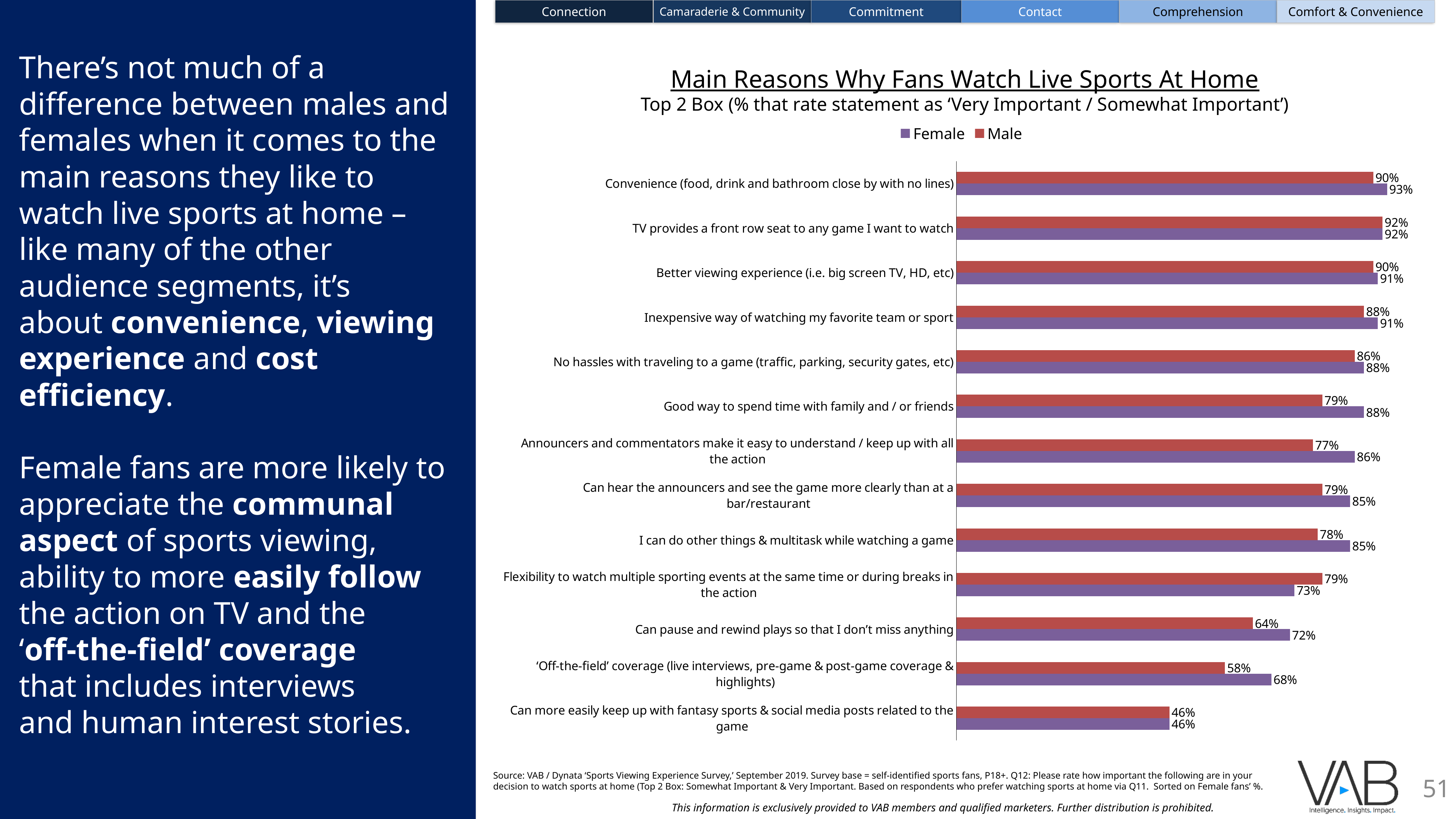
What is the difference between the Female and Male values for ''Off-the-field' coverage (live interviews, pre-game & post-game coverage & highlights)'? 10% What is the Male value for 'Can pause and rewind plays so that I don't miss anything'? 64% What is the difference between the Female and Male values for 'Good way to spend time with family and / or friends'? 9% What is the subtitle shown under the chart title? Top 2 Box (% that rate statement as 'Very Important / Somewhat Important') What kind of chart is shown on the slide? bar chart How many series does the legend list? 2 How many reasons (categories) are plotted in the chart? 13 Which reason has the lowest Female value? Can more easily keep up with fantasy sports & social media posts related to the game What is the Male value for 'Flexibility to watch multiple sporting events at the same time or during breaks in the action'? 79% For 'Flexibility to watch multiple sporting events at the same time or during breaks in the action', which is larger, the Female or the Male value? Male Which reason has the highest Male value? TV provides a front row seat to any game I want to watch What is the Female value for 'Convenience (food, drink and bathroom close by with no lines)'? 93%